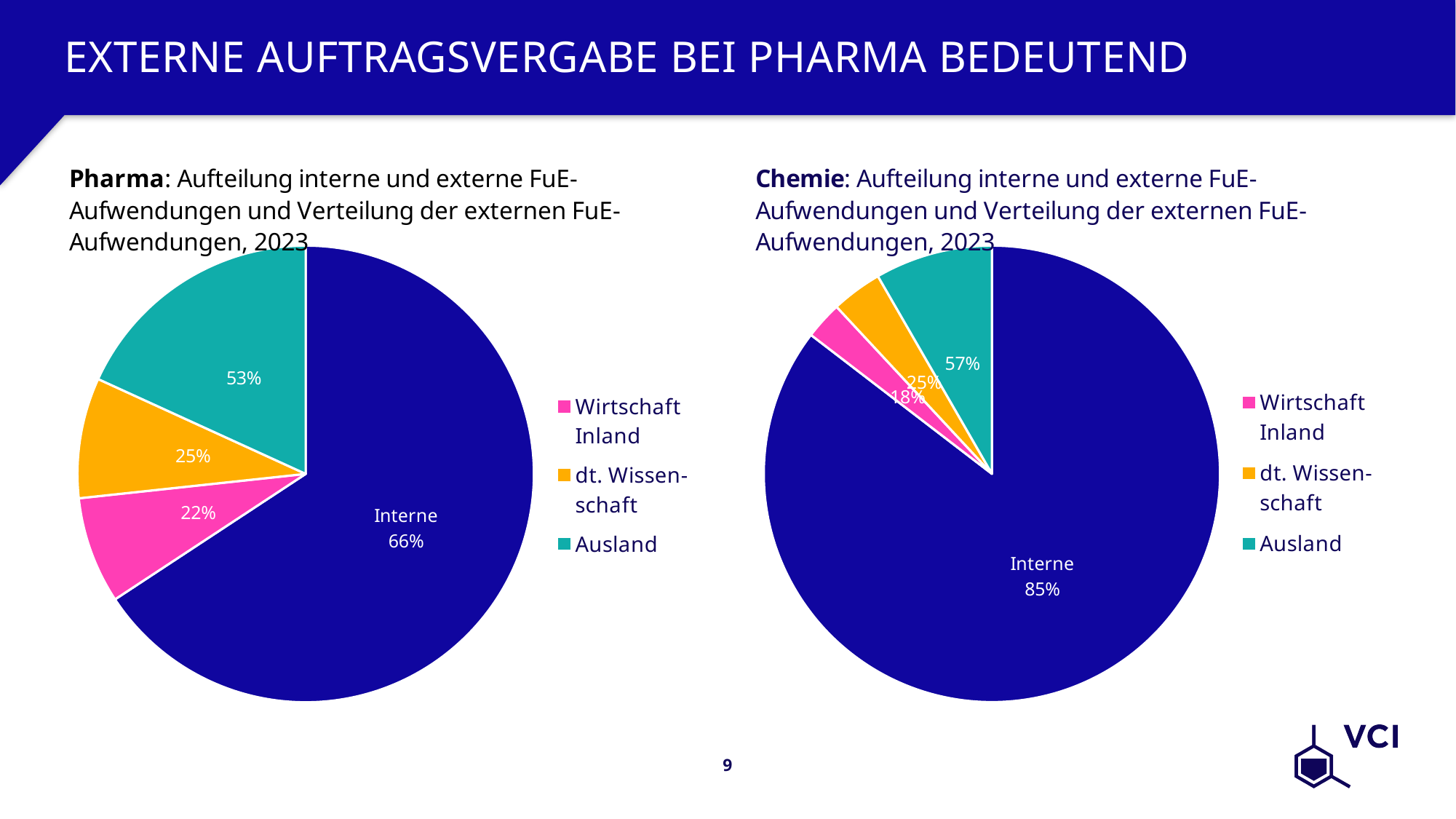
What type of chart is used on the left side of the slide for Pharma? Pie chart In the Pharma pie chart, what percentage is shown for the Interne slice? 66% In the Pharma pie chart, what percentage label is shown on the Ausland slice? 53% Which chart shows a larger Interne share, the Pharma chart or the Chemie chart? Chemie In the Chemie pie chart, what percentage label is shown on the Wirtschaft Inland slice? 18% In the Pharma pie chart, what percentage label is shown on the Wirtschaft Inland slice? 22% In the Pharma pie chart, what percentage label is shown on the dt. Wissenschaft slice? 25% In the Chemie pie chart, what percentage is shown for the Interne slice? 85% In the Chemie pie chart, what percentage label is shown on the Ausland slice? 57% What is the difference between the Interne percentage in the Chemie chart and the Interne percentage in the Pharma chart? 19% In the Chemie pie chart, which slice is the smallest? Wirtschaft Inland In the Pharma pie chart, which slice is the largest? Interne